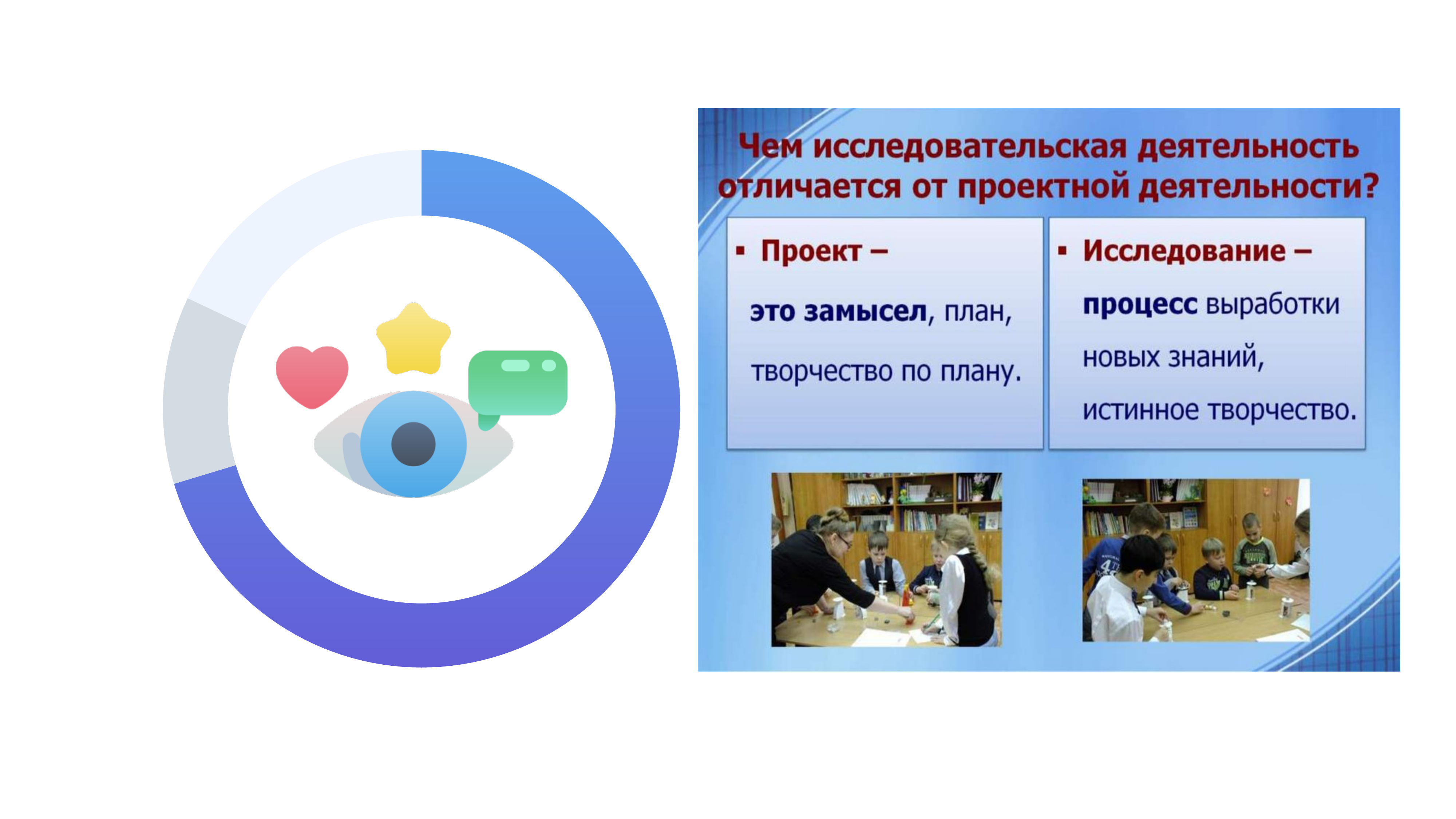
What kind of chart is shown on the left side of the slide? Doughnut chart Does the doughnut chart on the left display a legend? No Which colour segment of the doughnut chart on the left is the smallest? The grey segment Does the doughnut chart on the left show any data labels with values? No How many segments does the doughnut chart on the left contain? 3 Which colour segment of the doughnut chart on the left is the largest? The blue segment